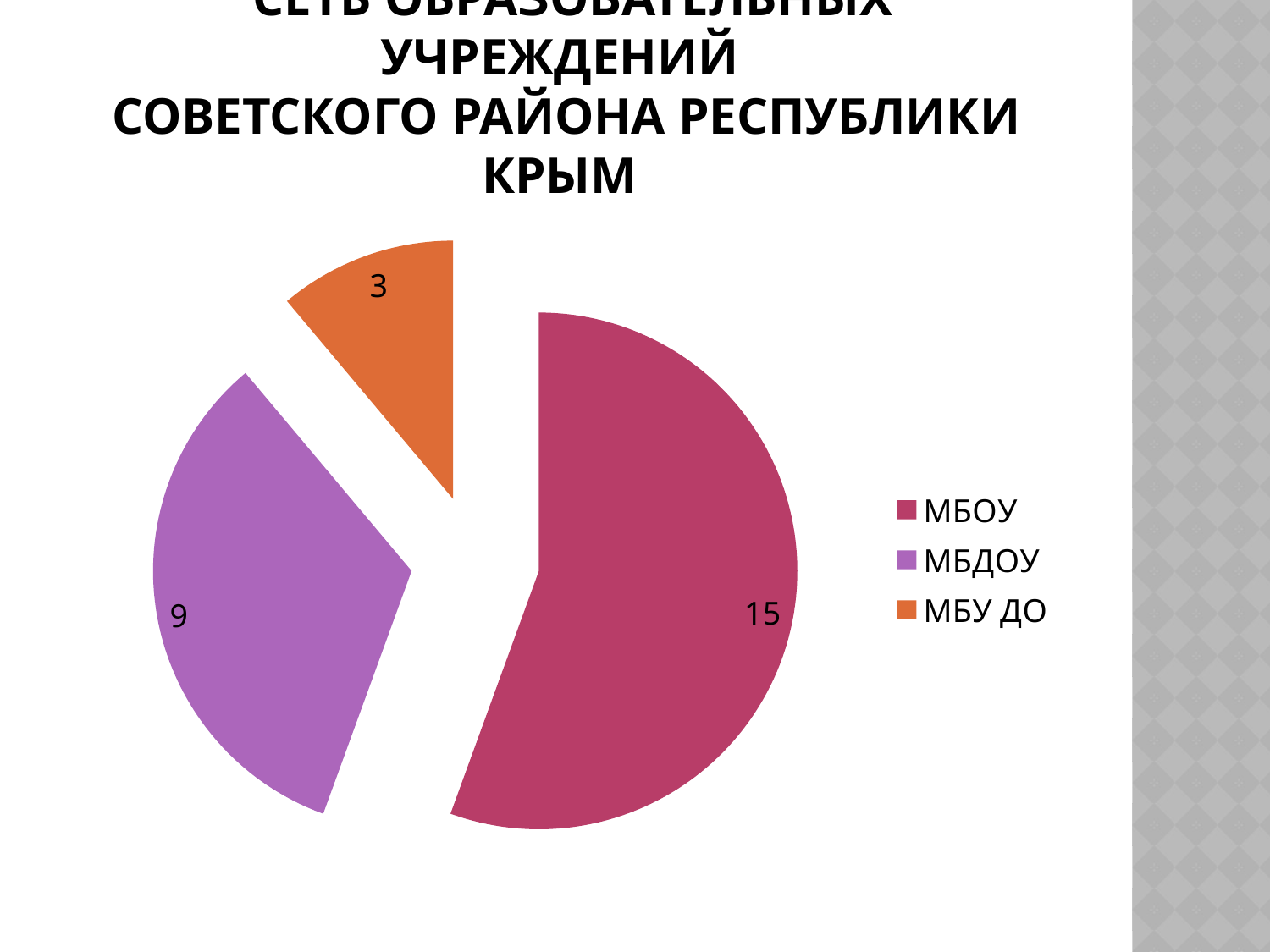
What is the value for МБОУ? 15 What is the value for МБДОУ? 9 What is the difference between the values for МБДОУ and МБУ ДО? 6 Which category has the largest slice? МБОУ What is the difference between the values for МБОУ and МБДОУ? 6 What colour is the slice for МБУ ДО? orange Which is larger, the value for МБДОУ or the value for МБУ ДО? МБДОУ What is the total of all slices in the pie chart? 27 How many slices does the pie chart have? 3 Which category has the smallest slice? МБУ ДО What kind of chart is shown on the slide? pie chart What is the value for МБУ ДО? 3